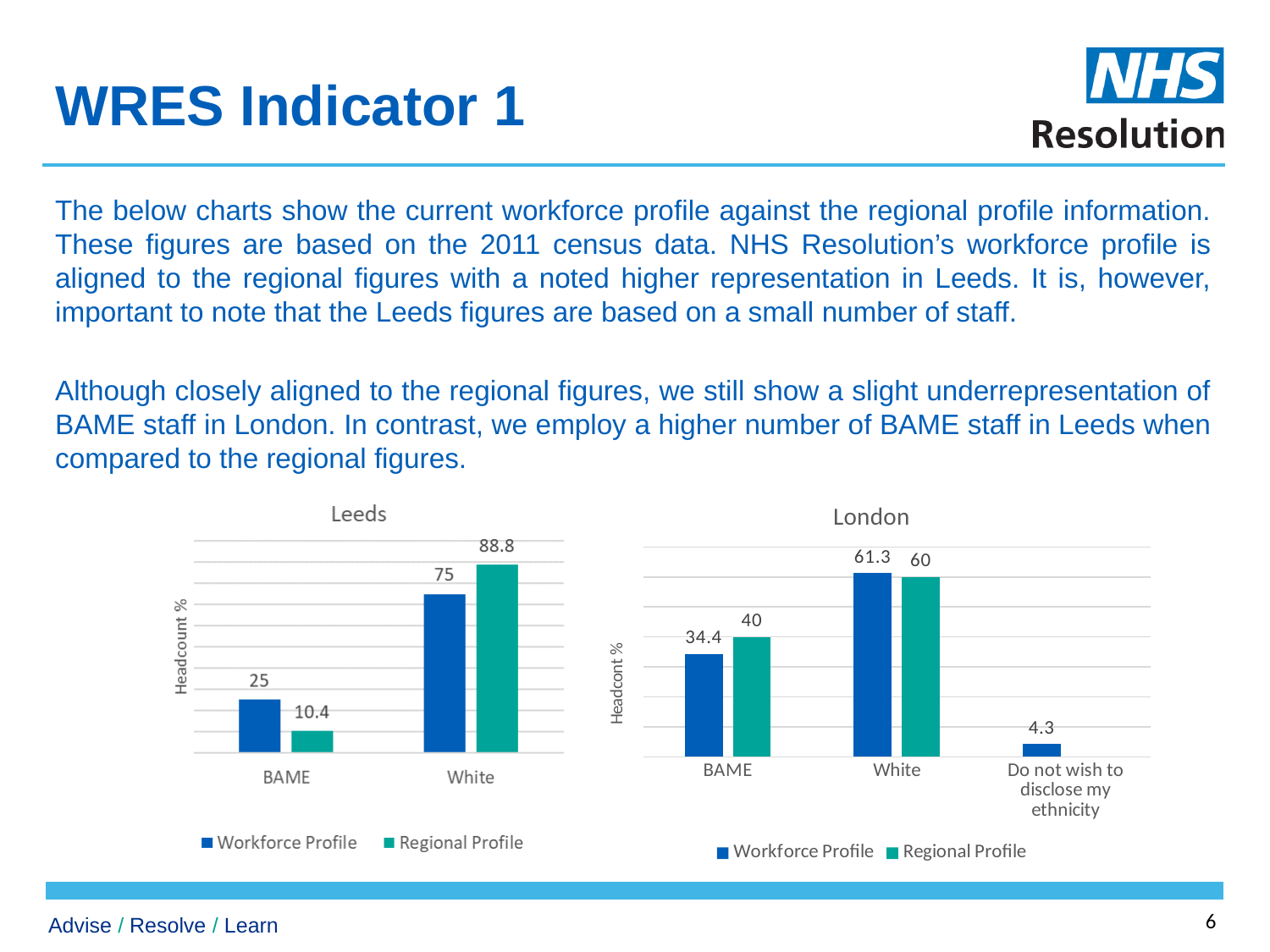
In the Leeds chart, what is the Regional Profile value for White? 88.8 In the Leeds chart, what is the difference between the Workforce Profile and Regional Profile values for BAME? 14.6 In the London chart, which is larger for White: the Workforce Profile or the Regional Profile? Workforce Profile How many categories are shown on the x axis of the London chart? 3 What type of chart is the Leeds chart? Bar chart How many series does the legend of the Leeds chart list? 2 In the London chart, which category has the lowest Workforce Profile value? Do not wish to disclose my ethnicity In the Leeds chart, which category has the highest Regional Profile value? White In the London chart, what is the Workforce Profile value for 'Do not wish to disclose my ethnicity'? 4.3 In the Leeds chart, what is the Workforce Profile value for BAME? 25 In the London chart, what is the difference between the Regional Profile and Workforce Profile values for BAME? 5.6 In the London chart, what is the Workforce Profile value for BAME? 34.4